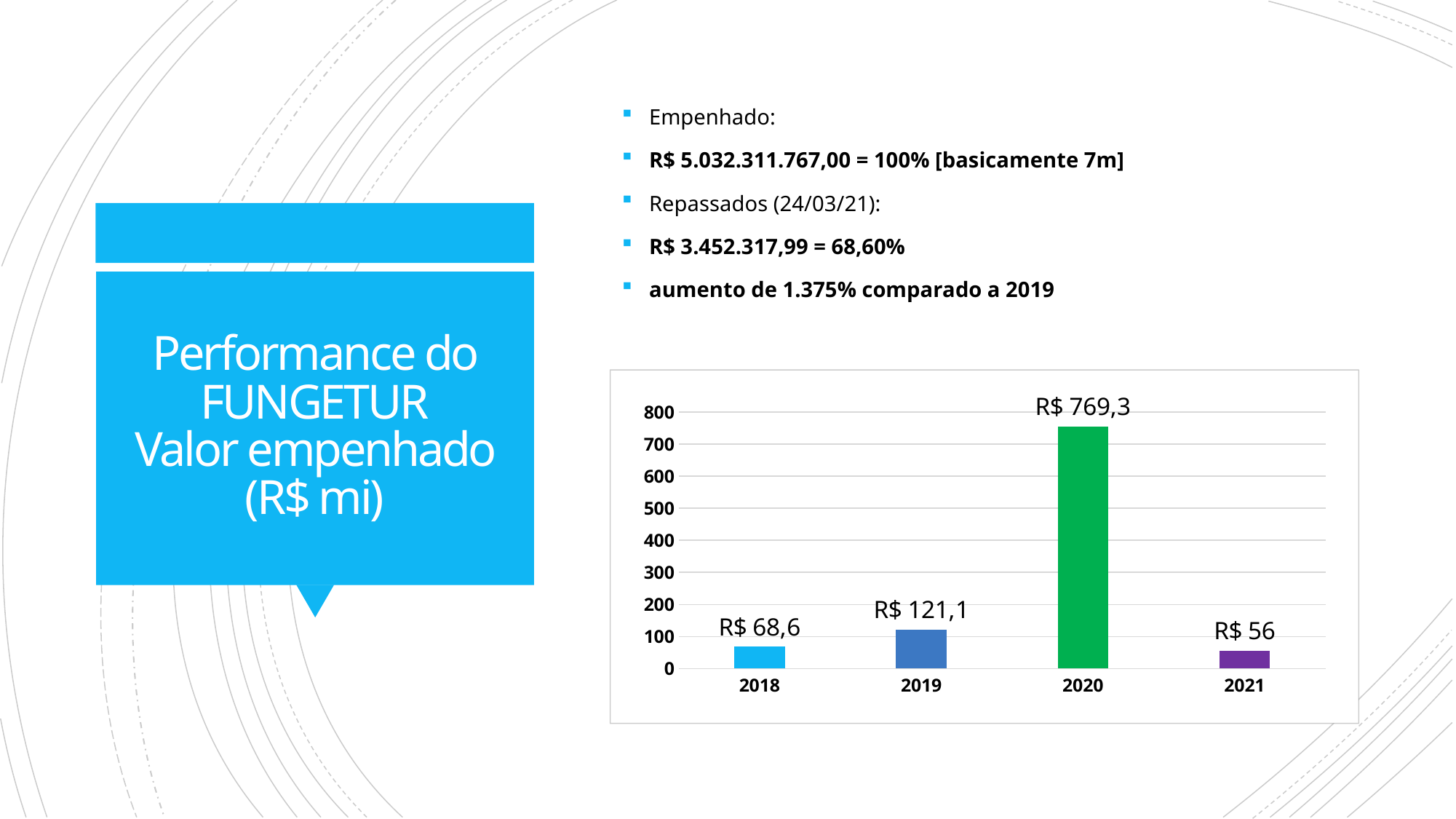
Which year has the lowest value? 2021 What is the value for 2020? R$ 769,3 How many years are shown on the chart? 4 What kind of chart is shown on the slide? Bar chart What is the value for 2021? R$ 56 What is the difference between the values for 2020 and 2019? R$ 648,2 What is the value for 2018? R$ 68,6 What is the difference between the values for 2018 and 2021? R$ 12,6 What colour is the bar for 2020? Green Which is larger, the value for 2018 or the value for 2019? 2019 What is the value for 2019? R$ 121,1 Which year has the highest value? 2020